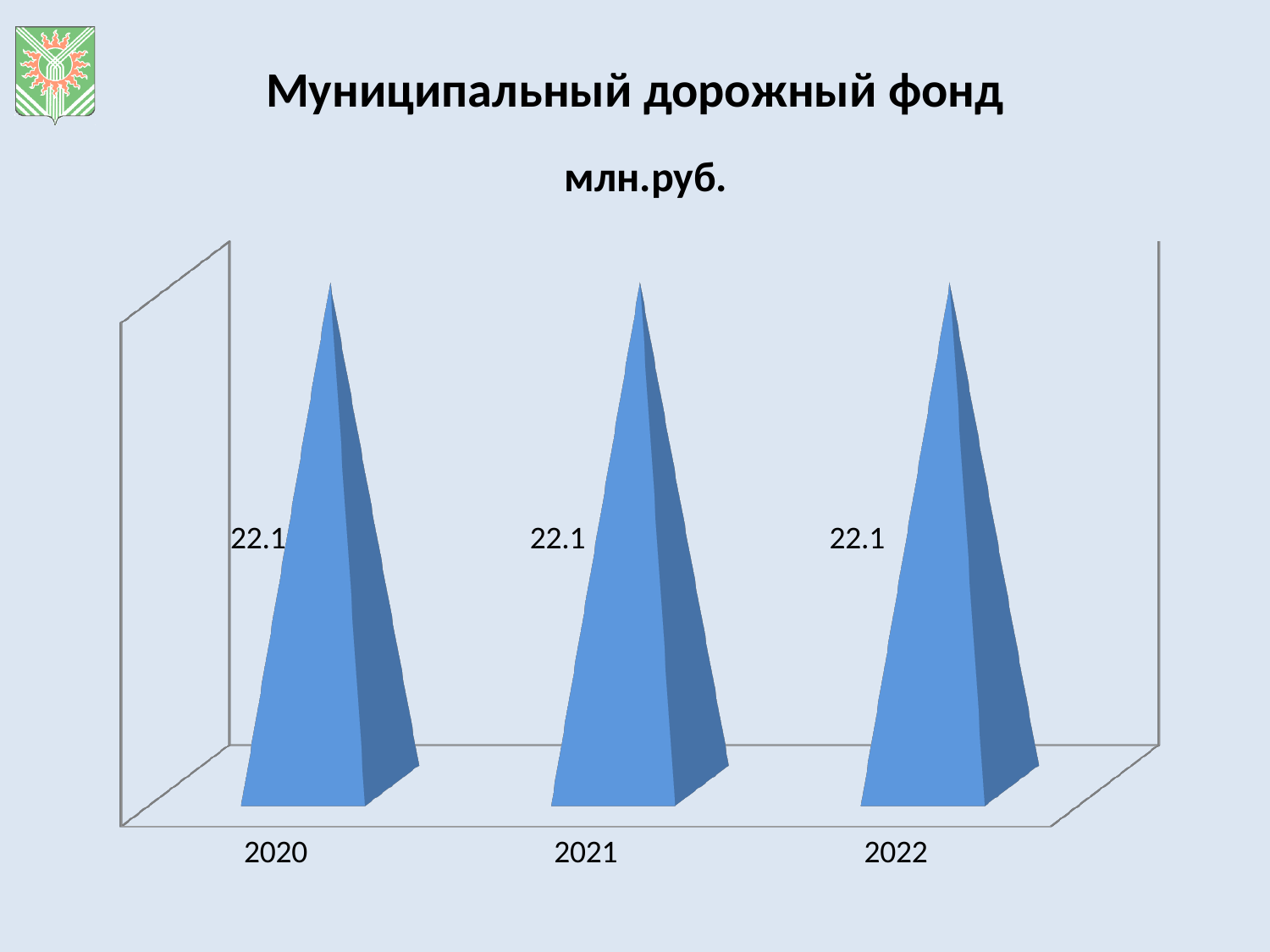
What is the value for 2021? 22.1 In what units are the values on the chart given? млн.руб. What is the difference between the values for 2022 and 2020? 0.0 How many categories are shown on the x axis? 3 What kind of chart is shown on the slide? Bar chart Do the values rise, fall or stay the same from 2020 to 2022? Stay the same Is the value for 2021 larger than, smaller than or equal to the value for 2020? Equal What is the value for 2022? 22.1 What is the title of the chart? млн.руб. What is the value for 2020? 22.1